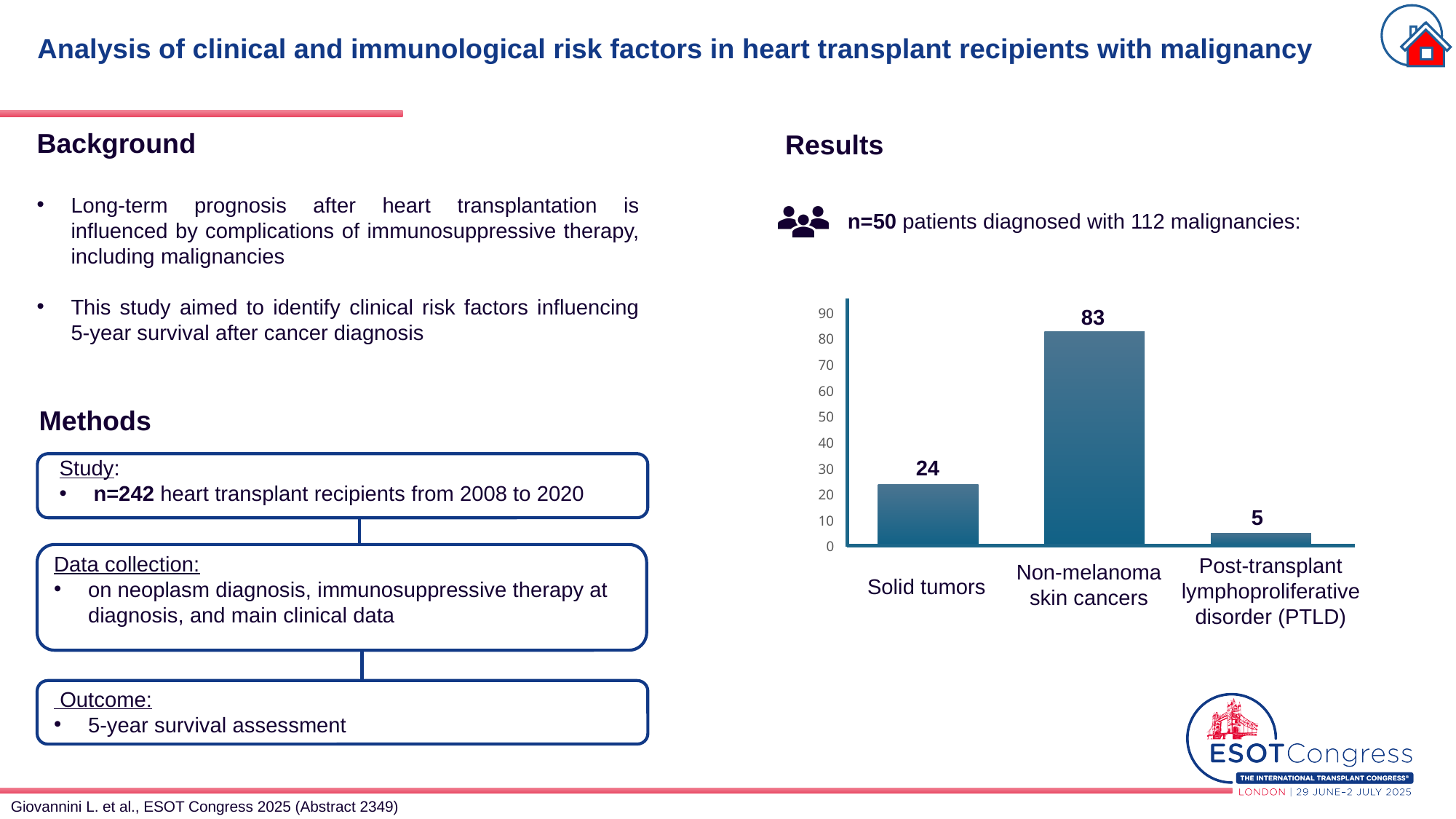
What is the value for Solid tumors in the chart? 24 Which is larger, the value for Solid tumors or the value for PTLD? Solid tumors Which category has the highest value in the chart? Non-melanoma skin cancers What is the highest value shown on the y axis of the chart? 90 How many categories are shown in the chart? 3 What is the value for Post-transplant lymphoproliferative disorder (PTLD) in the chart? 5 What kind of chart is shown on the slide? bar chart What is the difference between the values for Non-melanoma skin cancers and Solid tumors? 59 Is the value for Non-melanoma skin cancers greater or less than 80? greater Which category has the lowest value in the chart? Post-transplant lymphoproliferative disorder (PTLD) What is the value for Non-melanoma skin cancers in the chart? 83 What is the difference between the values for Solid tumors and Post-transplant lymphoproliferative disorder (PTLD)? 19